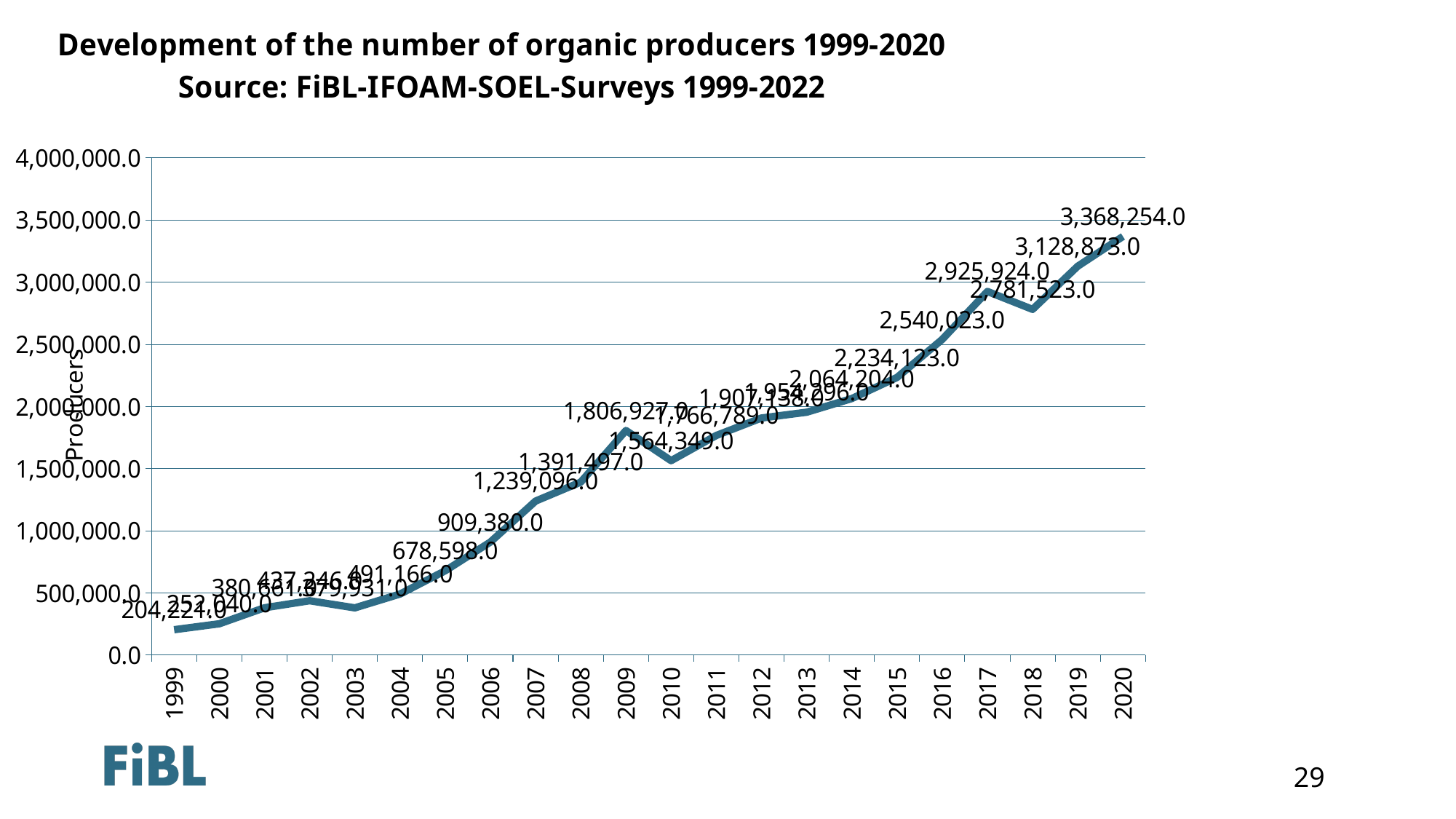
What is the number of organic producers shown for 2006? 909,380.0 What is the number of organic producers shown for 2020? 3,368,254.0 What is the difference between the number of producers in 2009 and in 2010? 242,578.0 Which year had more organic producers, 2017 or 2018? 2017 Which year has the lowest number of organic producers? 1999 By how much did the number of organic producers increase from 2019 to 2020? 239,381.0 What is the label of the vertical axis? Producers Which year has the highest number of organic producers? 2020 Is the value for 2003 greater or less than 500,000? less How many years are plotted on the x axis? 22 What is the number of organic producers shown for 2010? 1,564,349.0 What kind of chart is shown on the slide? line chart